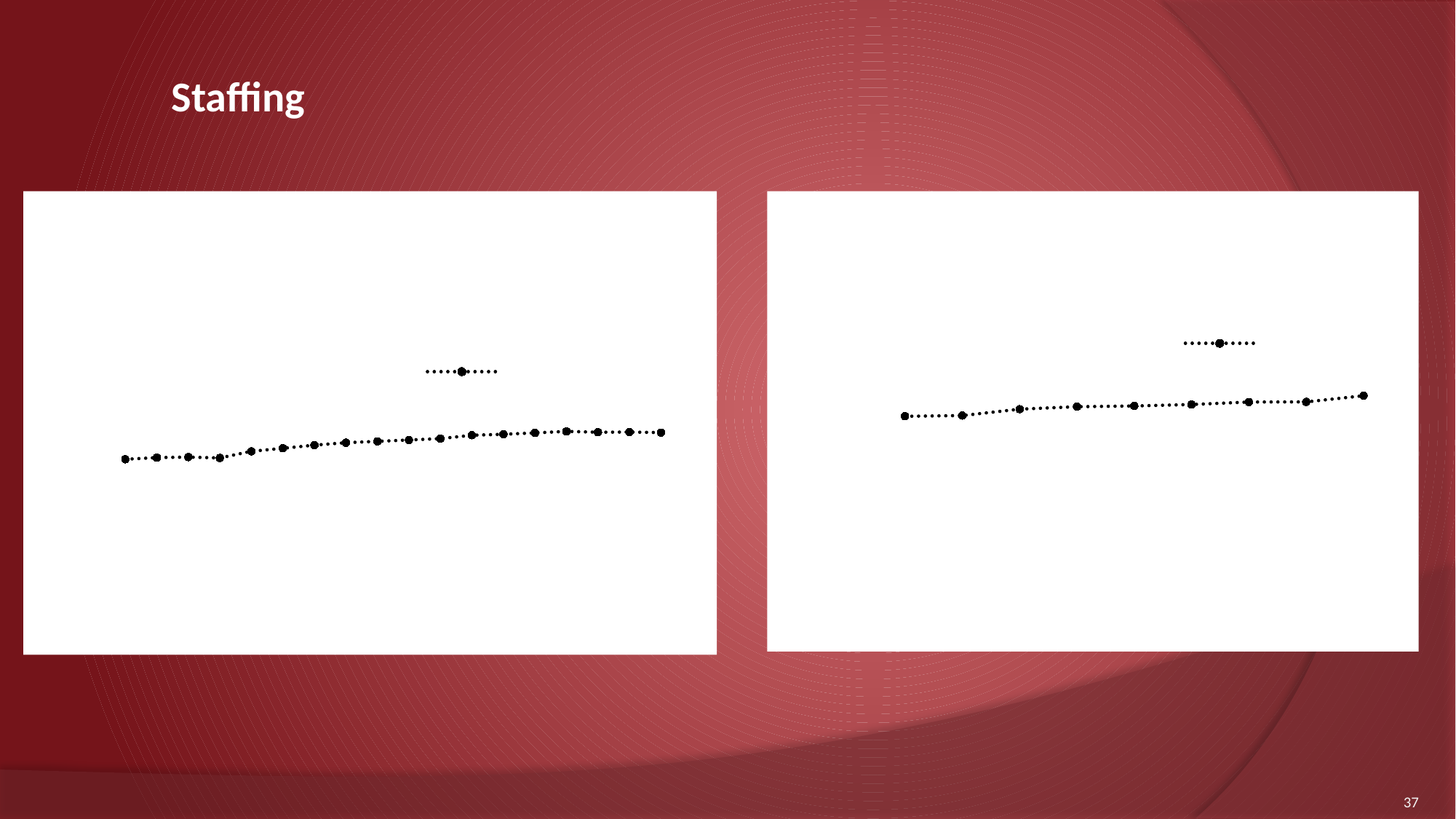
What line style is used for the series in the left chart? dotted line with markers In the left chart, do the values rise or fall from left to right along the x axis? rise What kind of chart is the left chart on the slide? line chart How many series does the legend of the left chart list? 1 In the right chart, do the values rise or fall from left to right along the x axis? rise What kind of chart is the right chart on the slide? line chart How many series does the legend of the right chart list? 1 In the left chart, how many data points are plotted on the line? 18 In the right chart, how many data points are plotted on the line? 9 What is the title shown at the top of the slide? Staffing